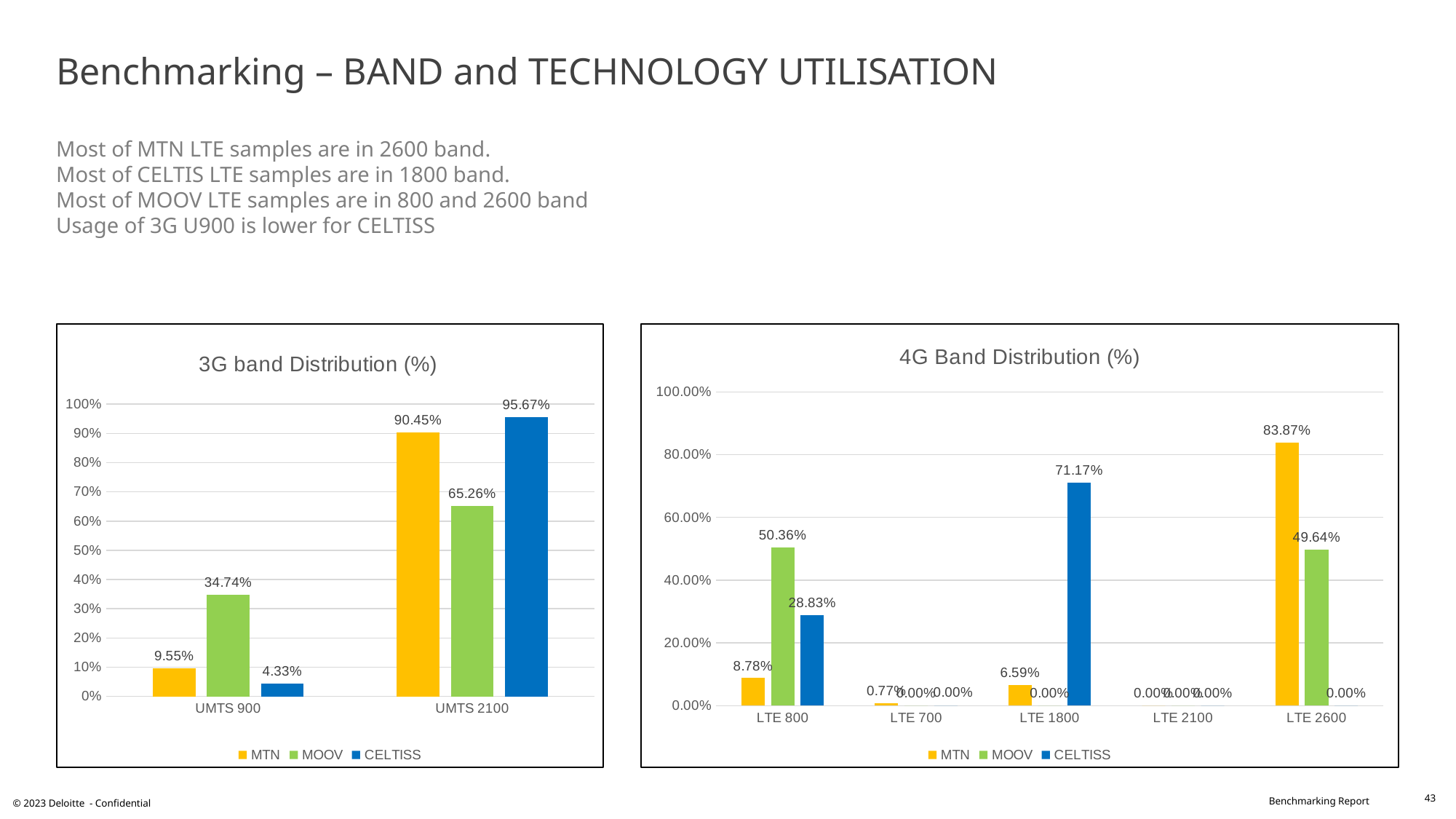
In the 4G Band Distribution (%) chart, which is larger: MOOV in LTE 800 or MOOV in LTE 2600? MOOV in LTE 800 In the 4G Band Distribution (%) chart, is the value for MTN in LTE 2600 greater or less than 80.00%? greater In the 3G band Distribution (%) chart, what is the value for CELTISS in UMTS 2100? 95.67% What type of chart is the 4G Band Distribution (%) chart? Bar chart In the 4G Band Distribution (%) chart, what is the value for MOOV in LTE 2600? 49.64% In the 3G band Distribution (%) chart, which operator has the lowest value in UMTS 900? CELTISS In the 4G Band Distribution (%) chart, which operator has the highest value in LTE 800? MOOV In the 3G band Distribution (%) chart, what is the value for MOOV in UMTS 900? 34.74% In the 3G band Distribution (%) chart, what is the difference between MTN's UMTS 2100 and UMTS 900 values? 80.90% In the 3G band Distribution (%) chart, how many series does the legend list? 3 In the 4G Band Distribution (%) chart, what is the value for CELTISS in LTE 1800? 71.17% In the 4G Band Distribution (%) chart, how many band categories are shown on the x axis? 5